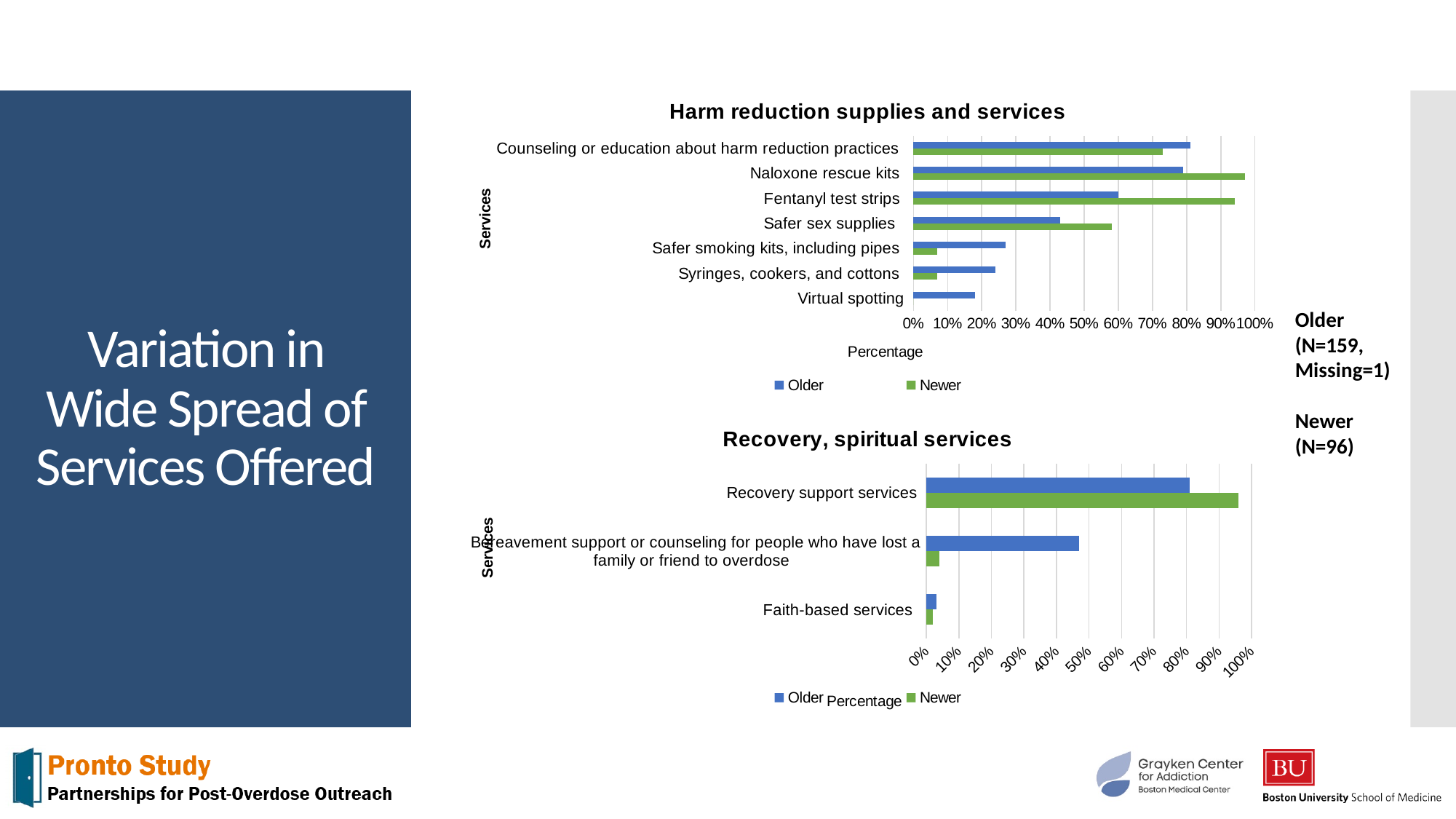
How many service categories are shown in the 'Harm reduction supplies and services' chart? 7 In the 'Recovery, spiritual services' chart, which service has the highest Older value? Recovery support services How many service categories are shown in the 'Recovery, spiritual services' chart? 3 In the 'Harm reduction supplies and services' chart, is the Newer value for Safer smoking kits, including pipes greater or less than 10%? less How many series does the legend of the 'Harm reduction supplies and services' chart list? 2 In the 'Harm reduction supplies and services' chart, is the Older value for Fentanyl test strips greater or less than 50%? greater What are the two legend entries in the 'Recovery, spiritual services' chart? Older and Newer In the 'Harm reduction supplies and services' chart, which is larger for Syringes, cookers, and cottons, Older or Newer? Older In the 'Harm reduction supplies and services' chart, which service has the lowest Older value? Virtual spotting In the 'Harm reduction supplies and services' chart, which is larger for Naloxone rescue kits, Older or Newer? Newer In the 'Recovery, spiritual services' chart, is the Older value for Bereavement support or counseling for people who have lost a family or friend to overdose greater or less than 40%? greater What kind of chart is the 'Harm reduction supplies and services' chart? bar chart